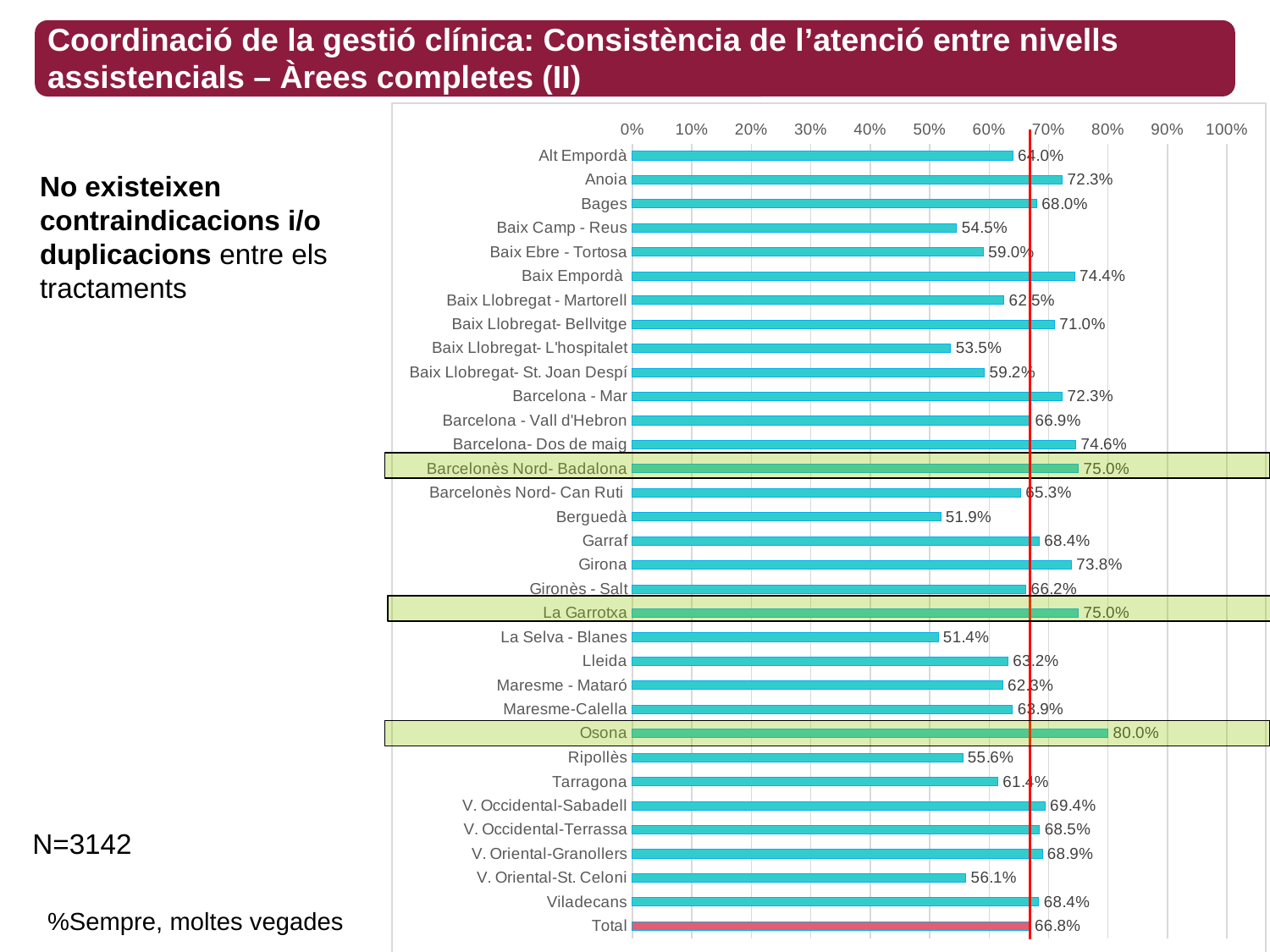
Which category has the lowest value? La Selva - Blanes Is the value for Ripollès greater or less than 60%? less What is the value for Baix Llobregat- L'hospitalet? 53.5% Which is larger, the value for Girona or the value for Berguedà? Girona What kind of chart is shown on the slide? bar chart What is the value for La Garrotxa? 75.0% Which category has the highest value? Osona Which bar is drawn in a different colour (red) from the others? Total How many bars are plotted in the chart, including Total? 33 What is the value for Osona? 80.0% What is the difference between the values for Osona and Total? 13.2% What is the value for Total? 66.8%